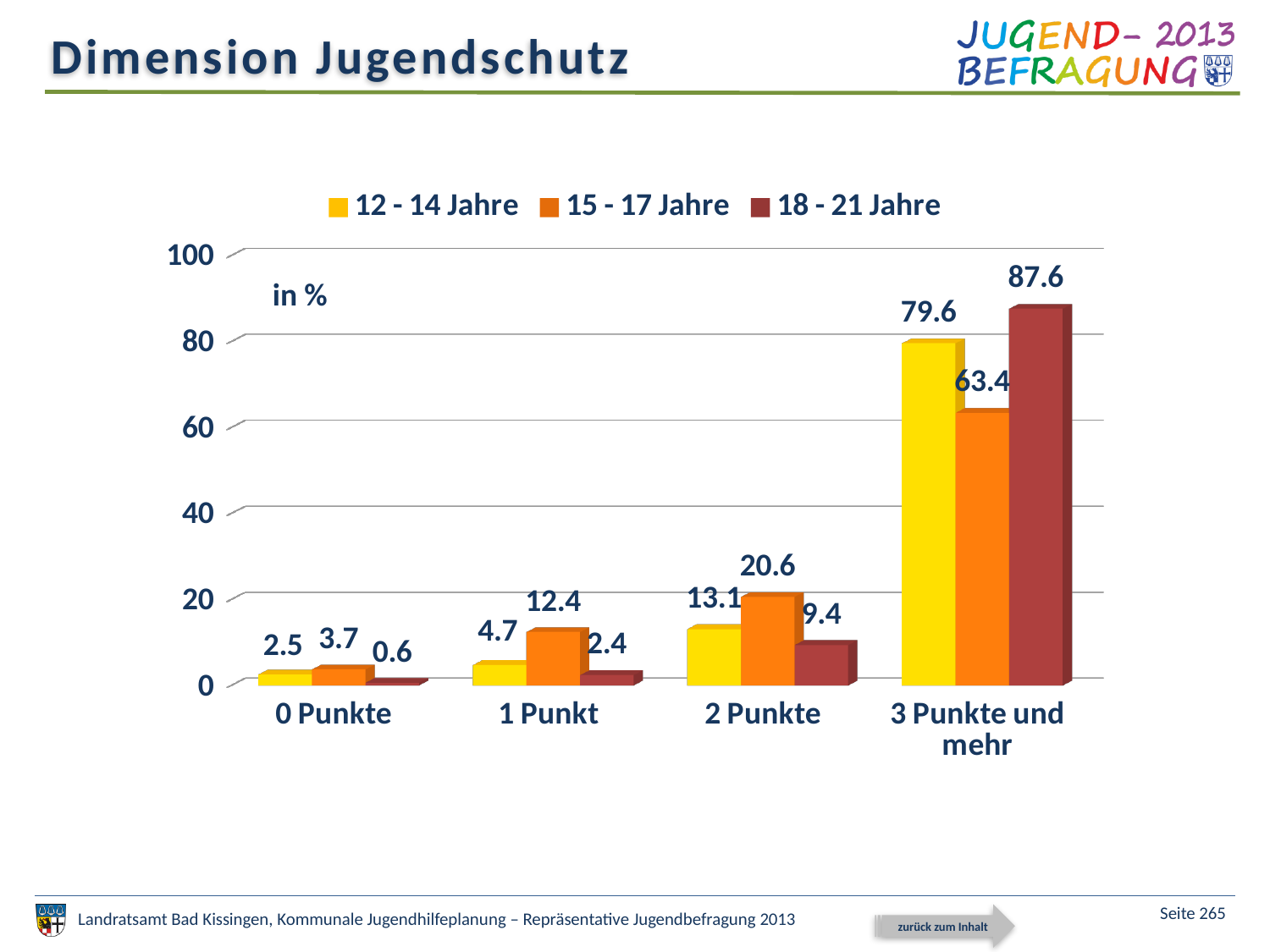
Is the value for 15 - 17 Jahre in the 3 Punkte und mehr category greater or less than 60? greater How many categories are shown on the x axis? 4 What kind of chart is shown on the slide? bar chart Which is larger in the 2 Punkte category: the value for 12 - 14 Jahre or for 18 - 21 Jahre? 12 - 14 Jahre Which age group has the lowest value in the 1 Punkt category? 18 - 21 Jahre How many series does the legend list? 3 What is the difference between the 18 - 21 Jahre and 15 - 17 Jahre values in the 3 Punkte und mehr category? 24.2 Which age group has the highest value in the 3 Punkte und mehr category? 18 - 21 Jahre What is the value for 12 - 14 Jahre in the 3 Punkte und mehr category? 79.6 What is the value for 18 - 21 Jahre in the 0 Punkte category? 0.6 What is the value for 15 - 17 Jahre in the 2 Punkte category? 20.6 What unit is indicated on the chart? in %